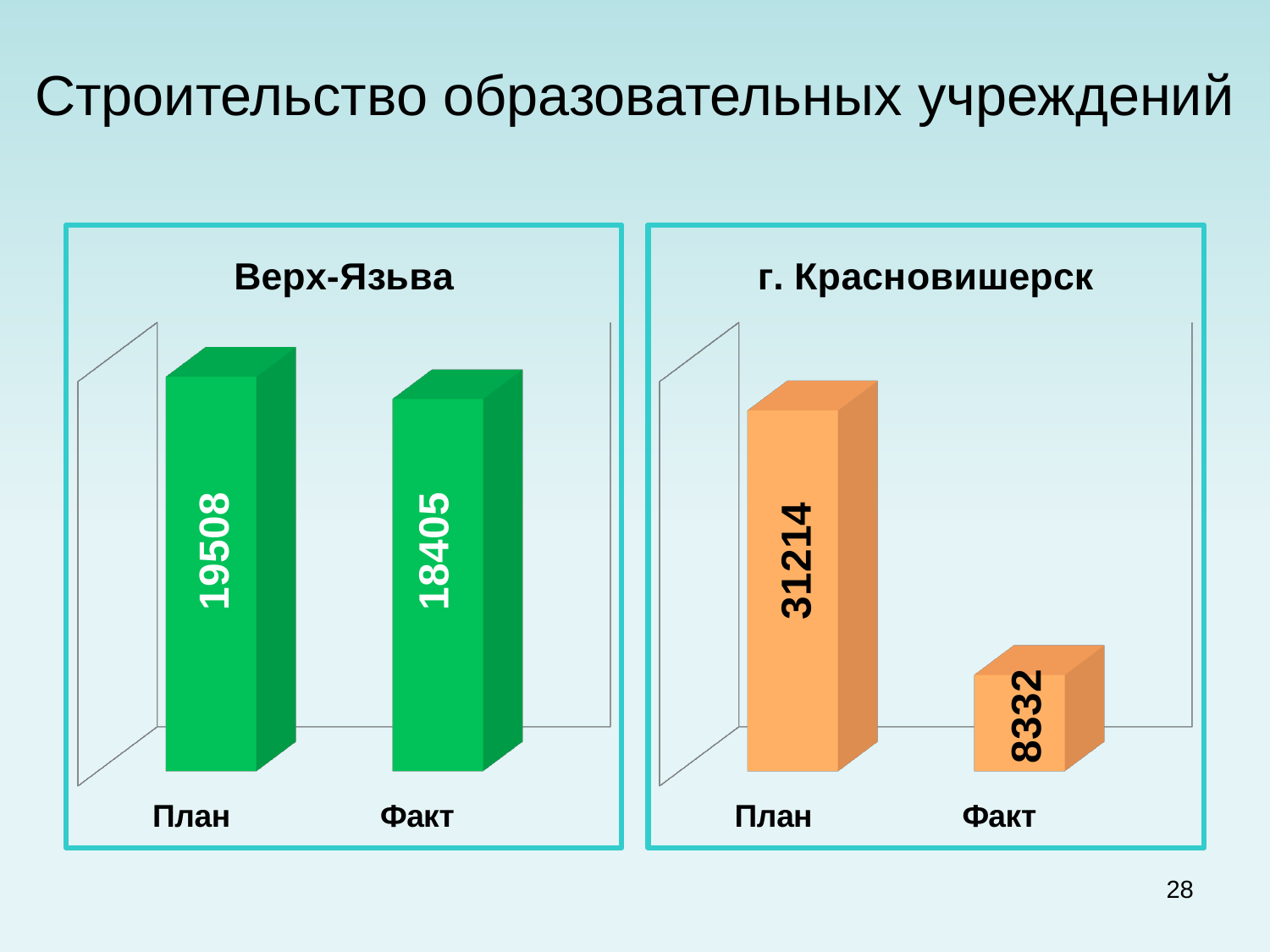
How many categories are shown in the "Верх-Язьва" chart? 2 In the "г. Красновишерск" chart, what is the difference between План and Факт? 22882 In the "г. Красновишерск" chart, which is larger, План or Факт? План What colour are the bars in the "Верх-Язьва" chart? Green In the "г. Красновишерск" chart, what is the value for План? 31214 In the "г. Красновишерск" chart, what is the value for Факт? 8332 In the "г. Красновишерск" chart, which category has the lowest value? Факт In the "Верх-Язьва" chart, what is the difference between План and Факт? 1103 In the "Верх-Язьва" chart, which category has the highest value? План In the "Верх-Язьва" chart, what is the value for План? 19508 What kind of chart is the "г. Красновишерск" chart? Bar chart In the "Верх-Язьва" chart, what is the value for Факт? 18405